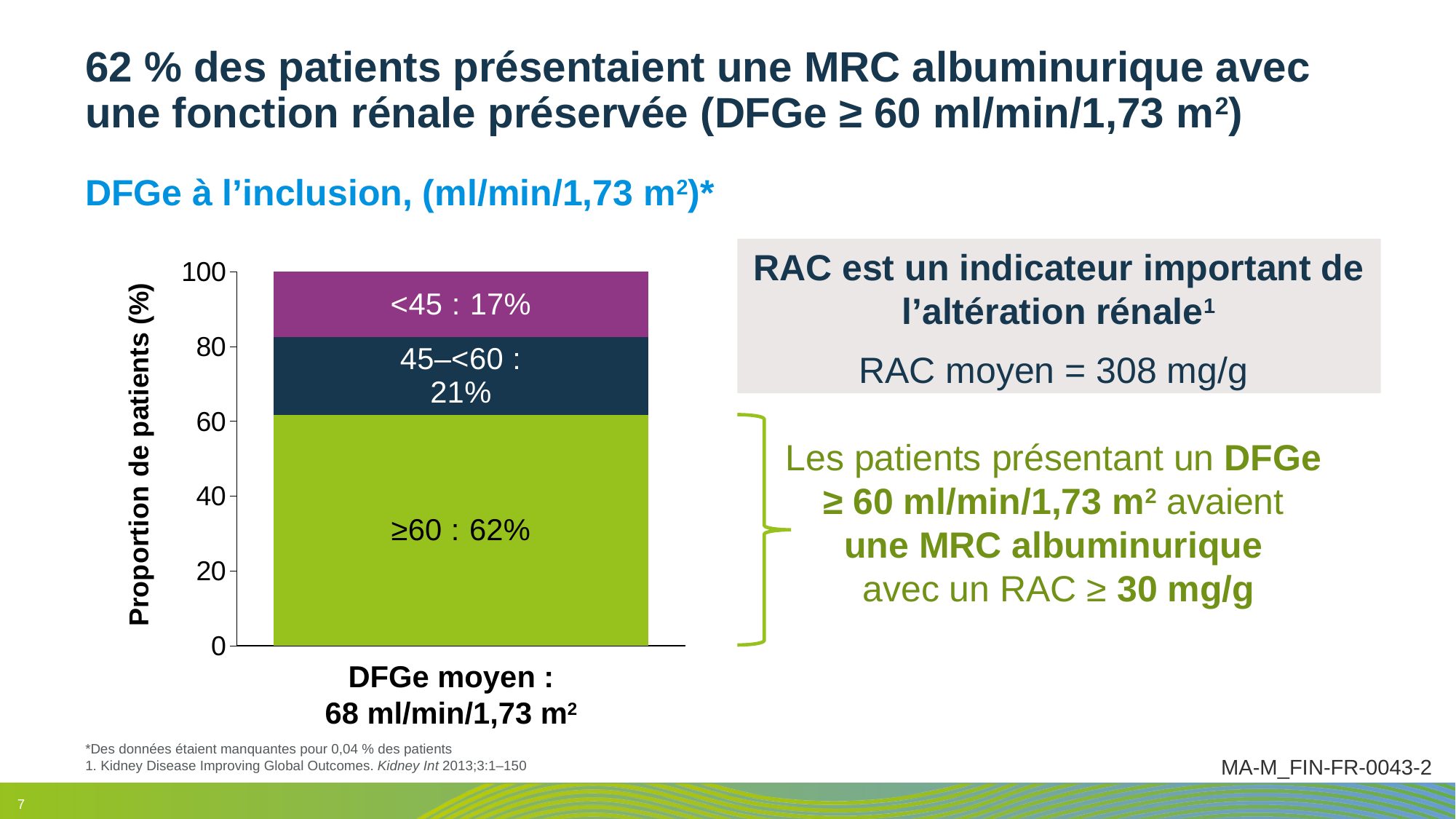
What kind of chart is shown on the slide? Stacked bar chart What is the total of the three stacked segments in the bar? 100% What proportion of patients had an eGFR (DFGe) of <45 ml/min/1.73 m²? 17% What proportion of patients had an eGFR (DFGe) of 45–<60 ml/min/1.73 m²? 21% What mean eGFR (DFGe moyen) is stated below the bar? 68 ml/min/1,73 m² Which segment is larger: 45–<60 or <45? 45–<60 What is the label of the y axis of the chart? Proportion de patients (%) Which eGFR category has the largest proportion of patients? ≥60 Which eGFR category has the smallest proportion of patients? <45 How many segments make up the stacked bar? 3 What proportion of patients had an eGFR (DFGe) of ≥60 ml/min/1.73 m²? 62% What is the difference in percentage points between the ≥60 segment and the <45 segment? 45